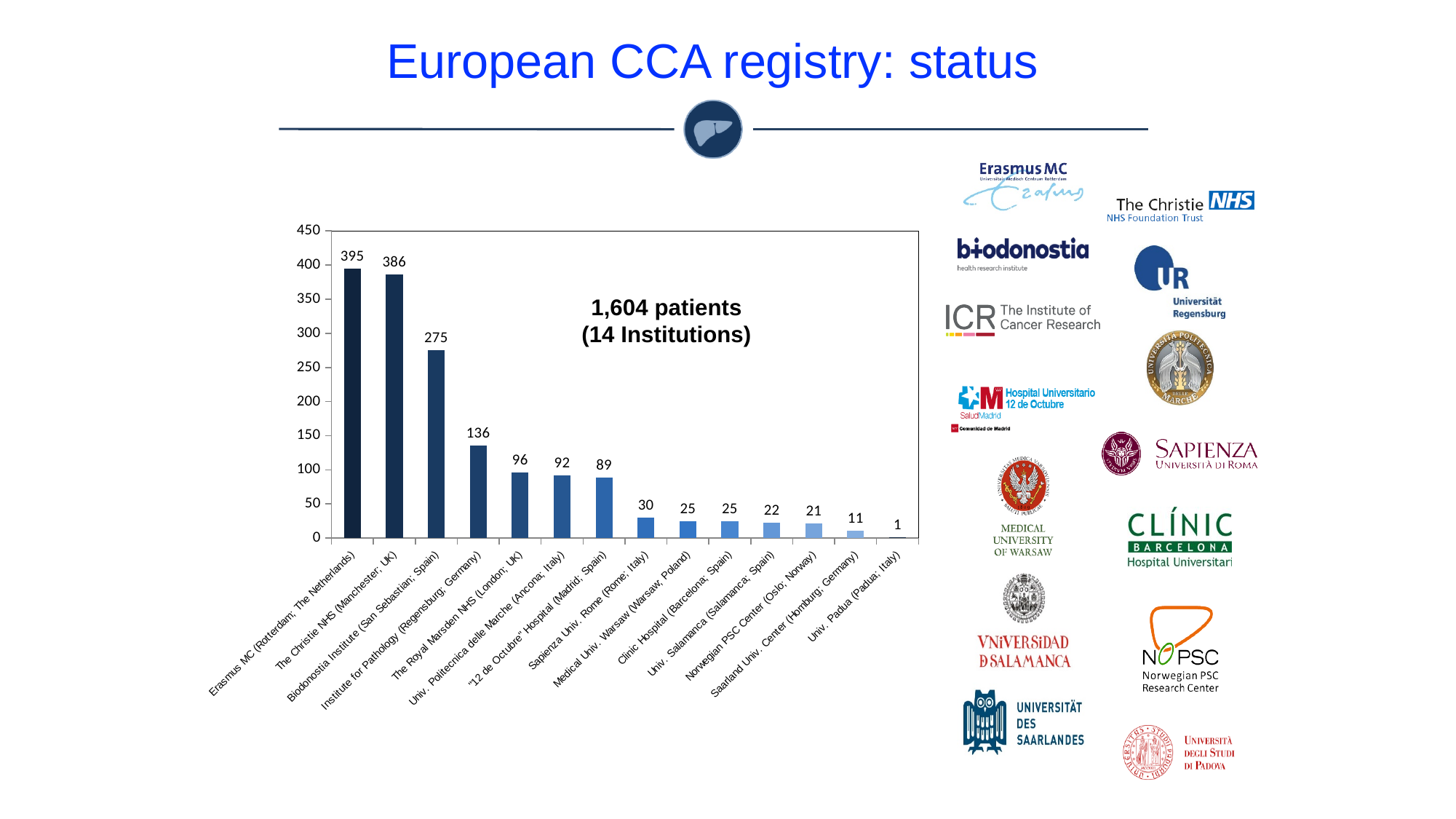
What is the value for Biodonostia Institute (San Sebastian, Spain)? 275 Which has a larger value: The Royal Marsden NHS (London, UK) or "12 de Octubre" Hospital (Madrid, Spain)? The Royal Marsden NHS (London, UK) What is the value for Norwegian PSC Center (Oslo, Norway)? 21 Do the values rise or fall from left to right along the x axis? Fall How many institutions (bars) are plotted in the chart? 14 Which institution has the highest value in the chart? Erasmus MC (Rotterdam, The Netherlands) What kind of chart is shown on the slide? Bar chart Which institution has the lowest value in the chart? Univ. Padua (Padua, Italy) What total number of patients is stated in the text inside the chart? 1,604 patients What is the value for Erasmus MC (Rotterdam, The Netherlands)? 395 What is the difference between the values for Erasmus MC (Rotterdam, The Netherlands) and The Christie NHS (Manchester, UK)? 9 What is the value for Institute for Pathology (Regensburg, Germany)? 136